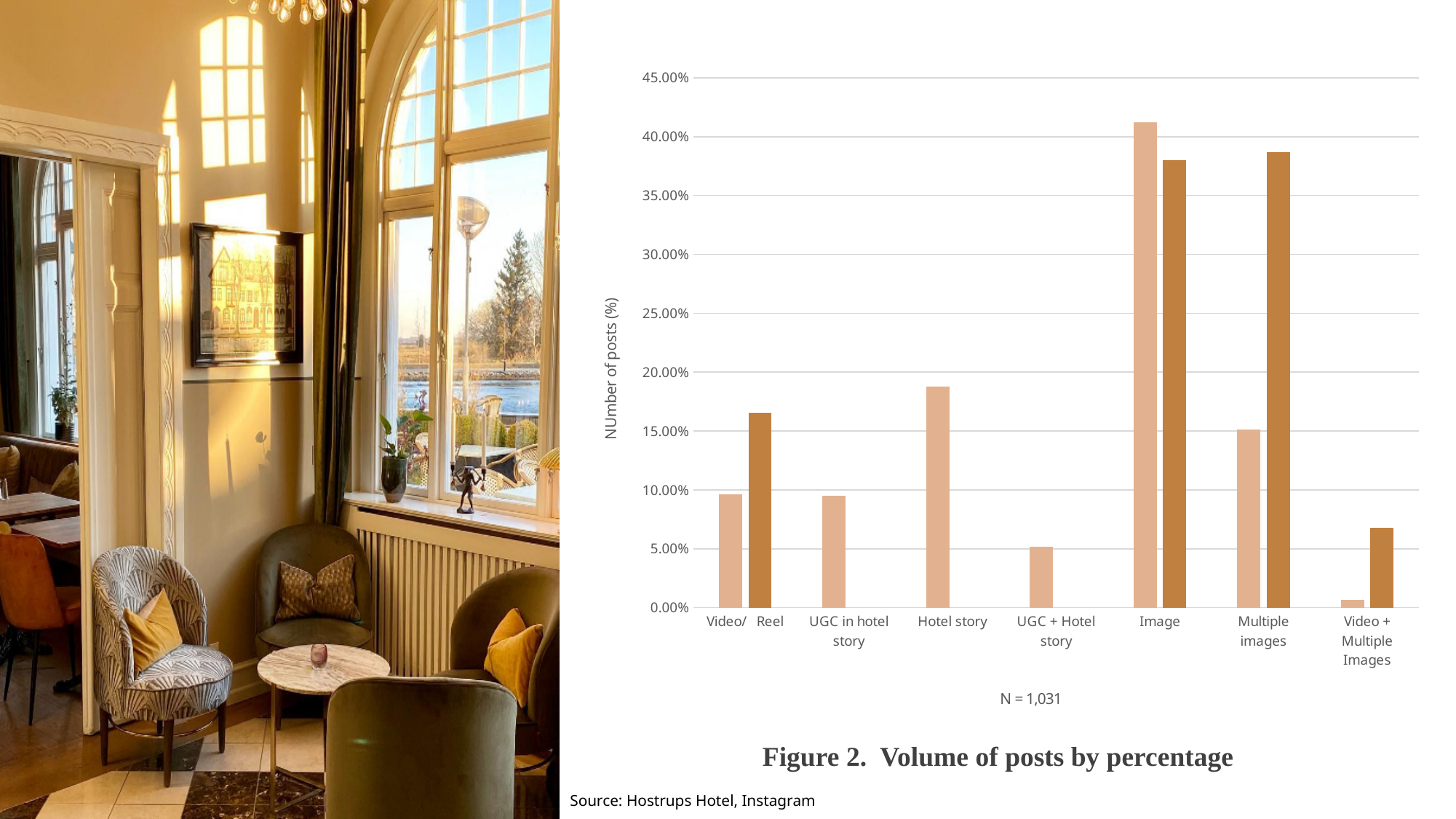
Which category has the shortest light-coloured bar in the chart? Video + Multiple Images Which category has the tallest bar in the chart? Image What is the title of the figure shown on the slide? Figure 2. Volume of posts by percentage Is the light-coloured bar for Image greater or less than 40.00%? greater Which light-coloured bar is larger, Hotel story or UGC in hotel story? Hotel story Is the light-coloured bar for UGC + Hotel story greater or less than 10.00%? less Is the dark-coloured bar for Video/ Reel greater or less than 15.00%? greater For Multiple images, which bar is larger, the light-coloured one or the dark-coloured one? the dark-coloured one What sample size (N) is stated below the chart? N = 1,031 How many categories are shown on the x axis of the chart? 7 What kind of chart is shown on the slide? bar chart